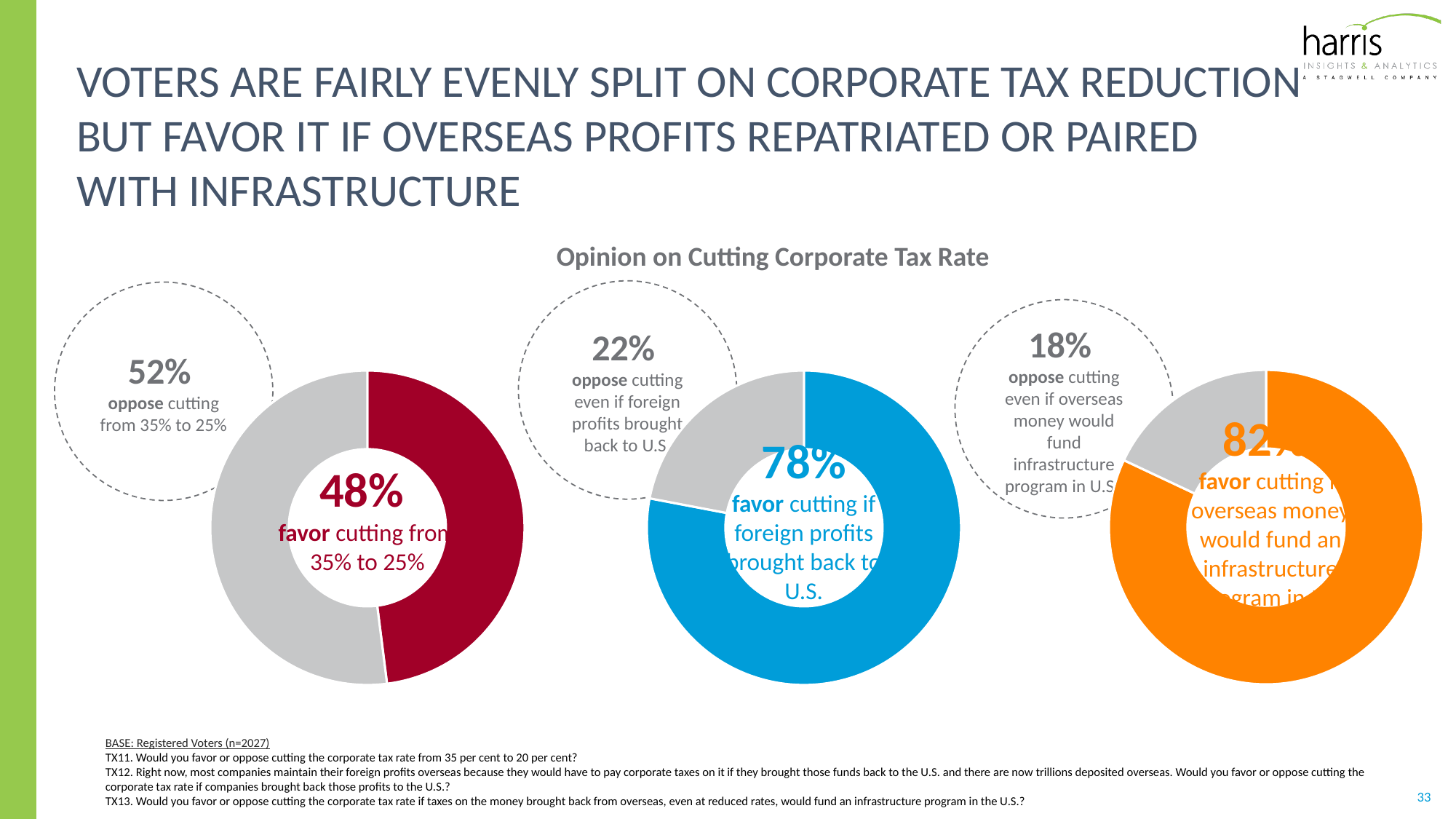
What is the difference in percentage points between the share favoring cutting if foreign profits are brought back (middle chart) and the share favoring cutting from 35% to 25% (left chart)? 30 percentage points Across the three donut charts, which scenario has the lowest share of voters in favor of cutting the corporate tax rate? Cutting from 35% to 25% (48%) On the left donut chart, which is larger: the share that favors cutting from 35% to 25% or the share that opposes it? The share that opposes (52%) Across the three donut charts, which scenario has the highest share of voters in favor of cutting the corporate tax rate? Cutting if overseas money would fund an infrastructure program (82%) On the right donut chart, what percentage of voters oppose cutting even if overseas money would fund an infrastructure program in the U.S.? 18% On the left donut chart, what percentage of voters oppose cutting the corporate tax rate from 35% to 25%? 52% On the middle donut chart, what percentage of voters oppose cutting even if foreign profits are brought back to the U.S.? 22% What type of chart is used to show the opinion data on this slide? Donut (pie) chart What is the title shown above the three donut charts? Opinion on Cutting Corporate Tax Rate On the middle donut chart, what percentage of voters favor cutting the corporate tax rate if foreign profits are brought back to the U.S.? 78% On the left donut chart, what percentage of voters favor cutting the corporate tax rate from 35% to 25%? 48% On the right donut chart, what percentage of voters favor cutting if overseas money would fund an infrastructure program? 82%